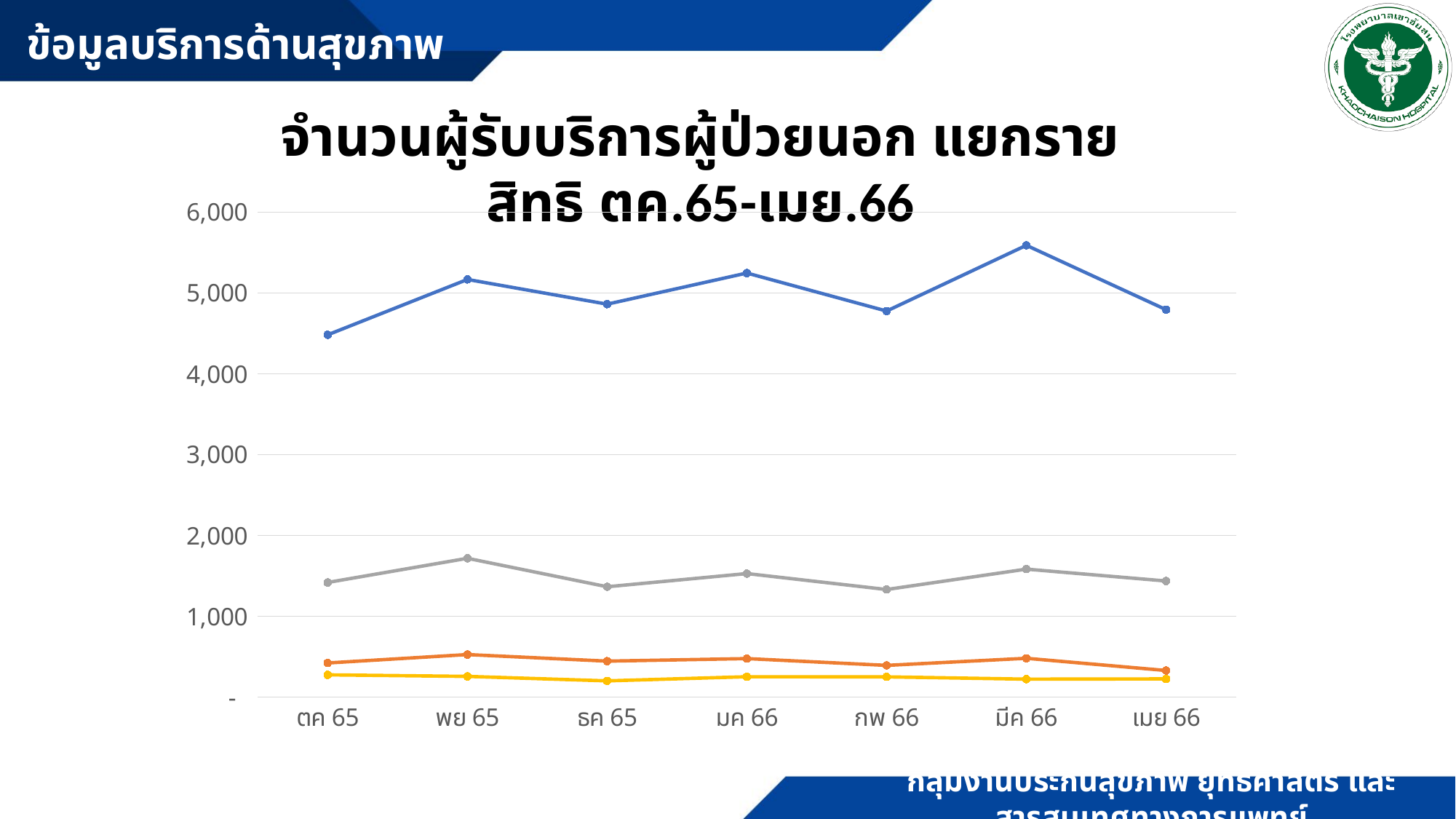
What kind of chart is shown on the slide? line chart In which month does the blue line reach its highest value? มีค 66 Which line has the larger value for มค 66, the blue line or the gray line? blue line Is the value of the blue line for มีค 66 greater or less than 5,000? greater Is the value of the gray line for พย 65 greater or less than 2,000? less How many months are plotted along the x axis of the chart? 7 How many lines are plotted in the chart? 4 Does the blue line rise or fall from มีค 66 to เมย 66? fall What is the title of the chart? จำนวนผู้รับบริการผู้ป่วยนอก แยกรายสิทธิ ตค.65-เมย.66 In which month does the gray line reach its highest value? พย 65 In which month does the blue line have its lowest value? ตค 65 Is the value of the blue line for ตค 65 greater or less than 5,000? less